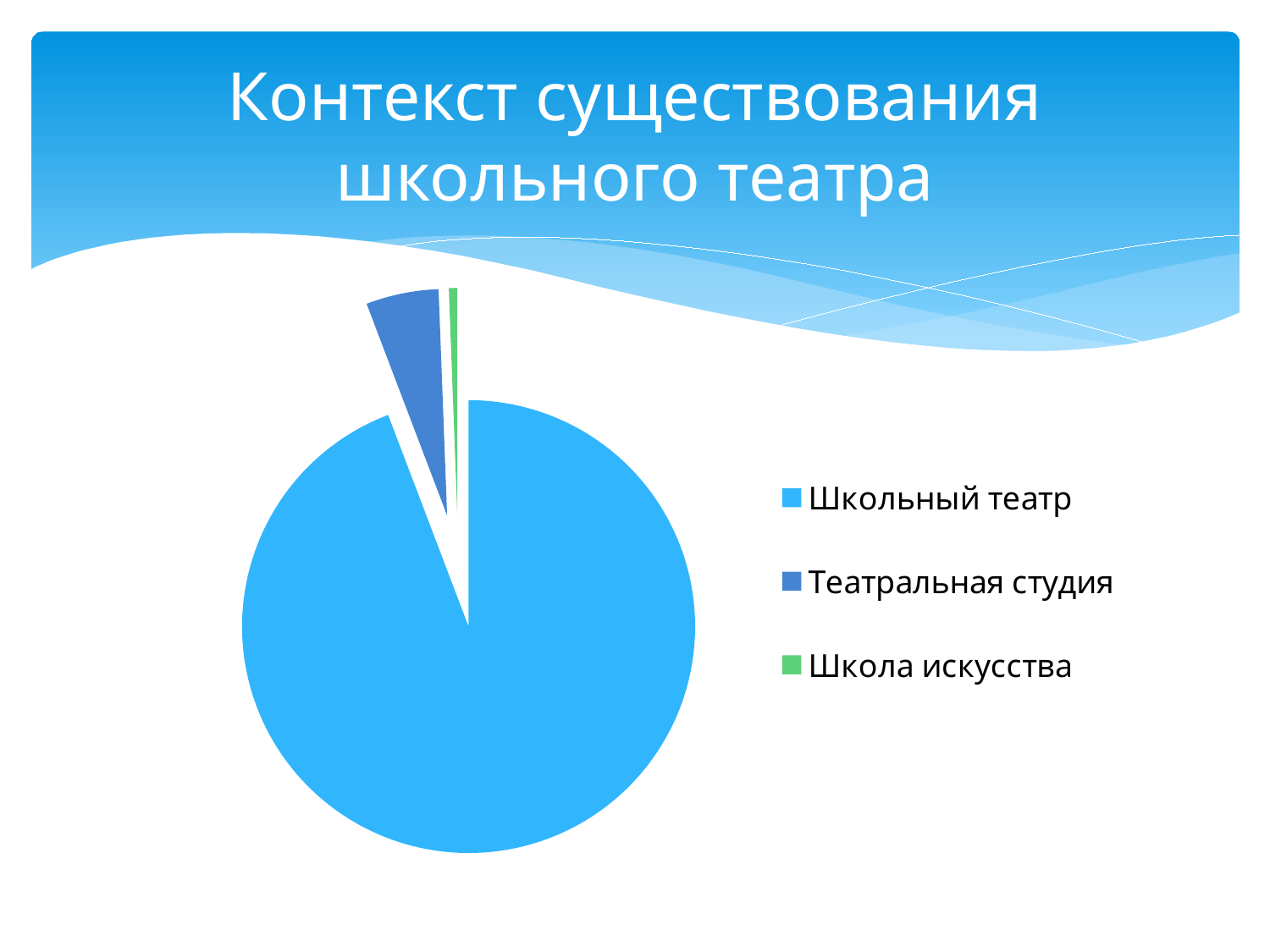
What colour is the slice for Школа искусства in the pie chart? green Does the slice for Школьный театр take up more or less than half of the pie? more How many slices does the pie chart have? 3 Which slice is larger: Школьный театр or Театральная студия? Школьный театр Which slice is larger: Театральная студия or Школа искусства? Театральная студия What kind of chart is shown on the slide? pie chart Which category has the largest slice in the pie chart? Школьный театр How many entries does the legend of the pie chart list? 3 What is the title of the slide containing the pie chart? Контекст существования школьного театра Which category has the smallest slice in the pie chart? Школа искусства